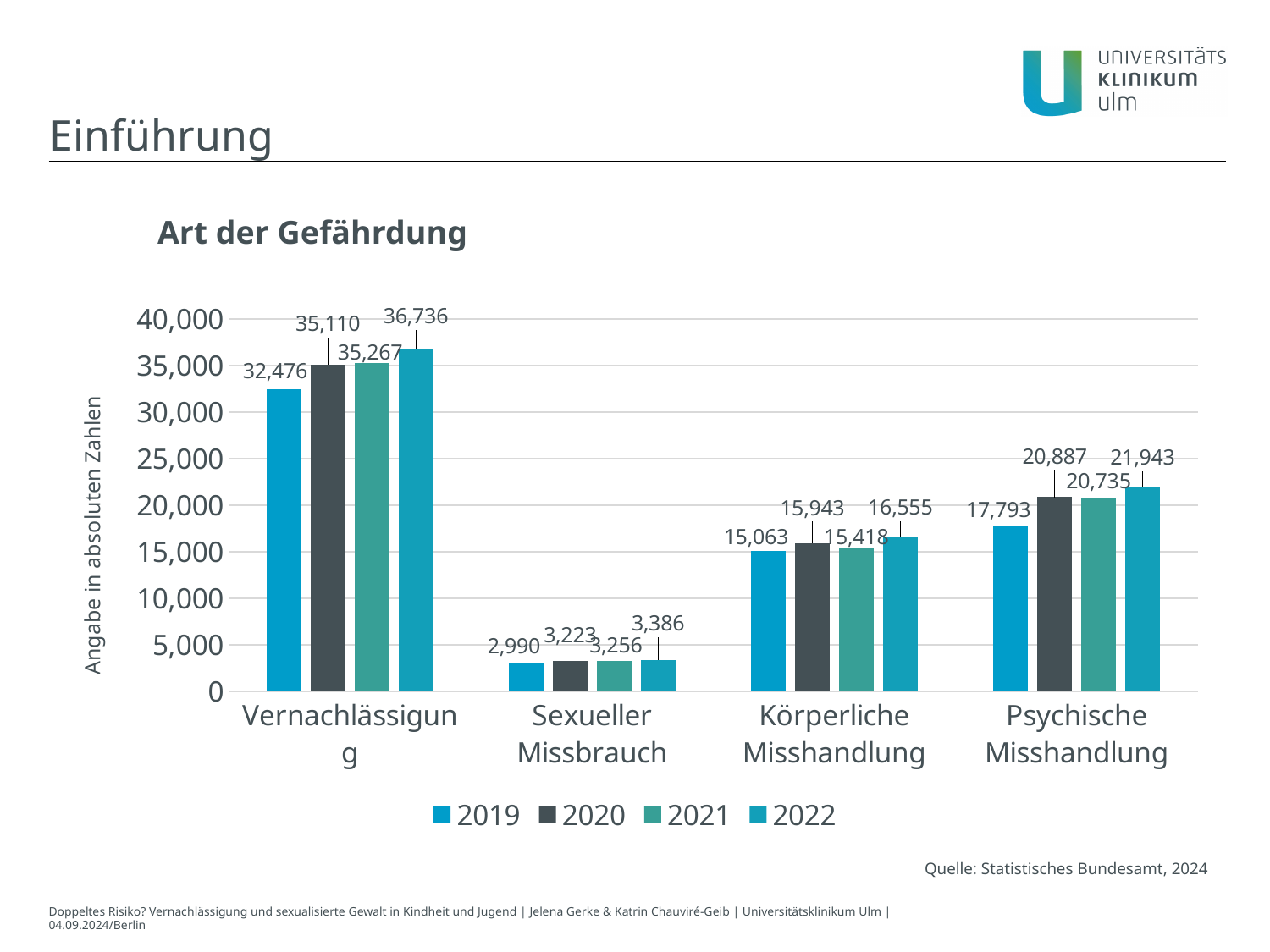
What is the difference between the 2022 and 2019 values for Vernachlässigung? 4,260 What is the value for Vernachlässigung in 2022? 36,736 What is the value for Körperliche Misshandlung in 2021? 15,418 How many categories are shown on the x axis? 4 What is the value for Sexueller Missbrauch in 2019? 2,990 What is the value for Psychische Misshandlung in 2020? 20,887 Which category has the lowest value in 2019? Sexueller Missbrauch Which category has the highest value in 2022? Vernachlässigung How many series does the legend list? 4 What is the title of the chart? Art der Gefährdung What kind of chart is shown? Bar chart Which is larger for Körperliche Misshandlung: the 2020 value or the 2021 value? 2020